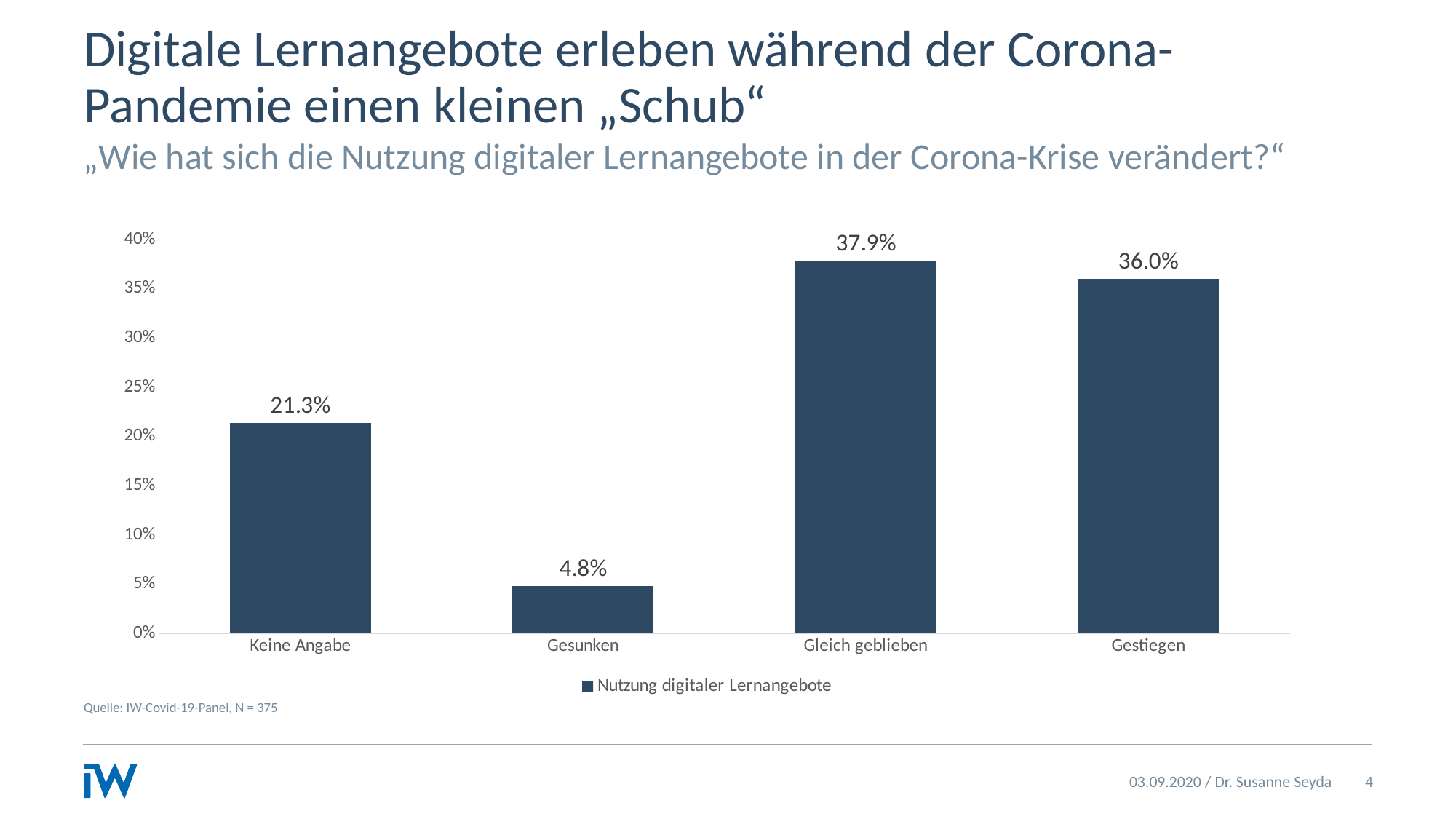
What is the value for "Gleich geblieben"? 37.9% How many categories are shown on the x axis? 4 What is the value for "Gestiegen"? 36.0% What is the value for "Keine Angabe"? 21.3% What is the difference between the values for "Gestiegen" and "Gesunken"? 31.2% Which category has the lowest value? Gesunken Which is larger, the value for "Keine Angabe" or the value for "Gestiegen"? Gestiegen What is the value for "Gesunken"? 4.8% Which category has the highest value? Gleich geblieben What series name does the legend show? Nutzung digitaler Lernangebote Is the value for "Keine Angabe" greater or less than 25%? less What kind of chart is shown on the slide? bar chart